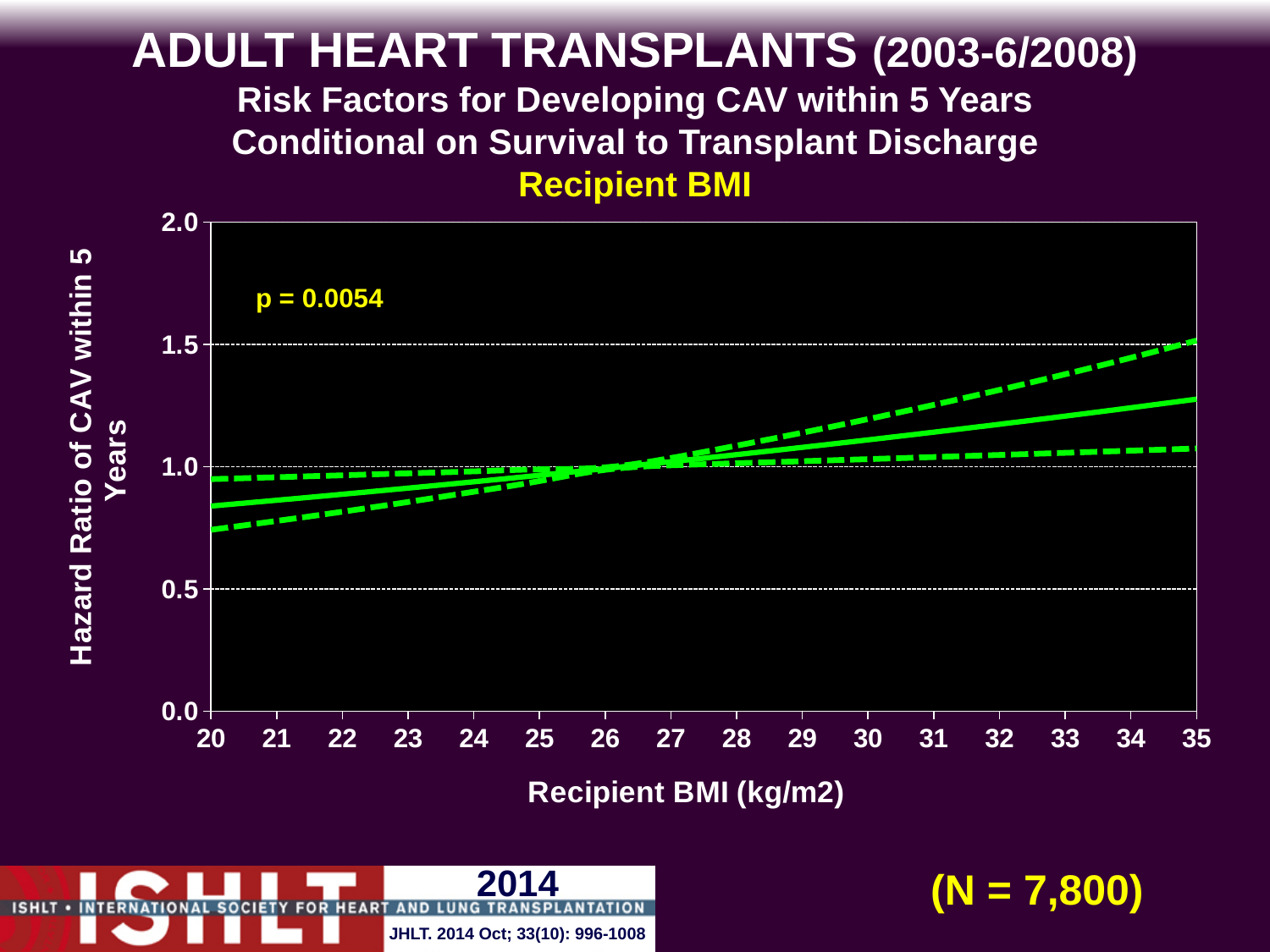
What p-value is printed on the chart? p = 0.0054 Is the hazard ratio on the solid line at a recipient BMI of 20 greater or less than 1.0? less What kind of chart is shown on the slide? line chart Is the lower dashed line at a recipient BMI of 20 greater or less than 1.0? less Is the hazard ratio on the solid line at a recipient BMI of 35 greater or less than 1.0? greater What is the label of the y axis? Hazard Ratio of CAV within 5 Years What is the lowest recipient BMI value shown on the x axis? 20 What is the highest recipient BMI value shown on the x axis? 35 How many recipient BMI values are labelled on the x axis? 16 Does the solid hazard ratio line rise or fall as recipient BMI increases from 20 to 35? rise